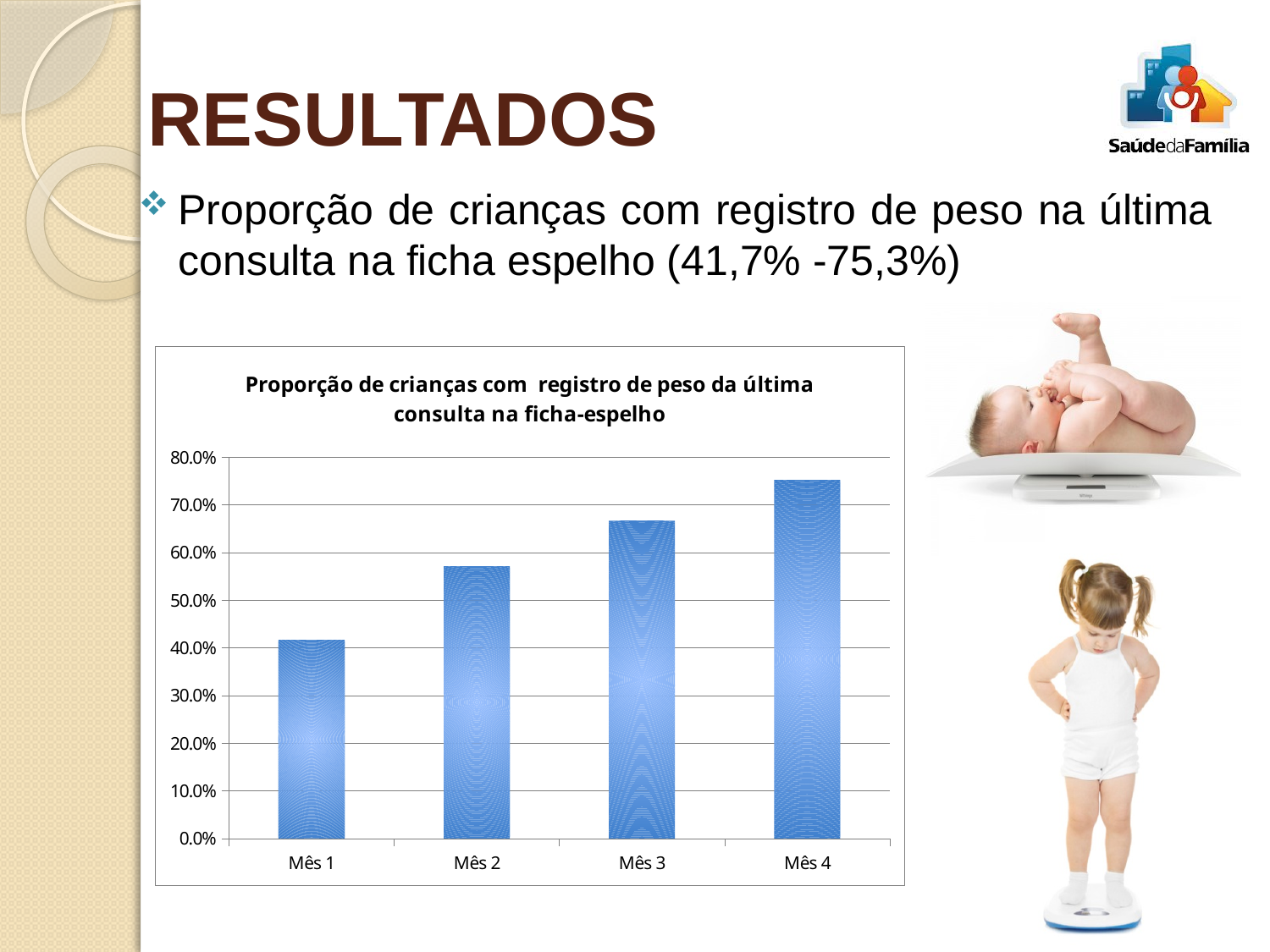
Is the value for Mês 3 greater or less than 70.0%? less Do the values rise or fall from Mês 1 to Mês 4? Rise Is the value for Mês 2 greater or less than 50.0%? greater Which month has the lowest proportion in the chart? Mês 1 How many months (categories) are plotted on the chart? 4 Which month has the highest proportion in the chart? Mês 4 What is the highest value shown on the chart's vertical axis? 80.0% Is the value for Mês 4 greater or less than 70.0%? greater What is the title of the chart? Proporção de crianças com registro de peso da última consulta na ficha-espelho What kind of chart is shown on the slide? Bar chart Which is larger, the value for Mês 2 or the value for Mês 3? Mês 3